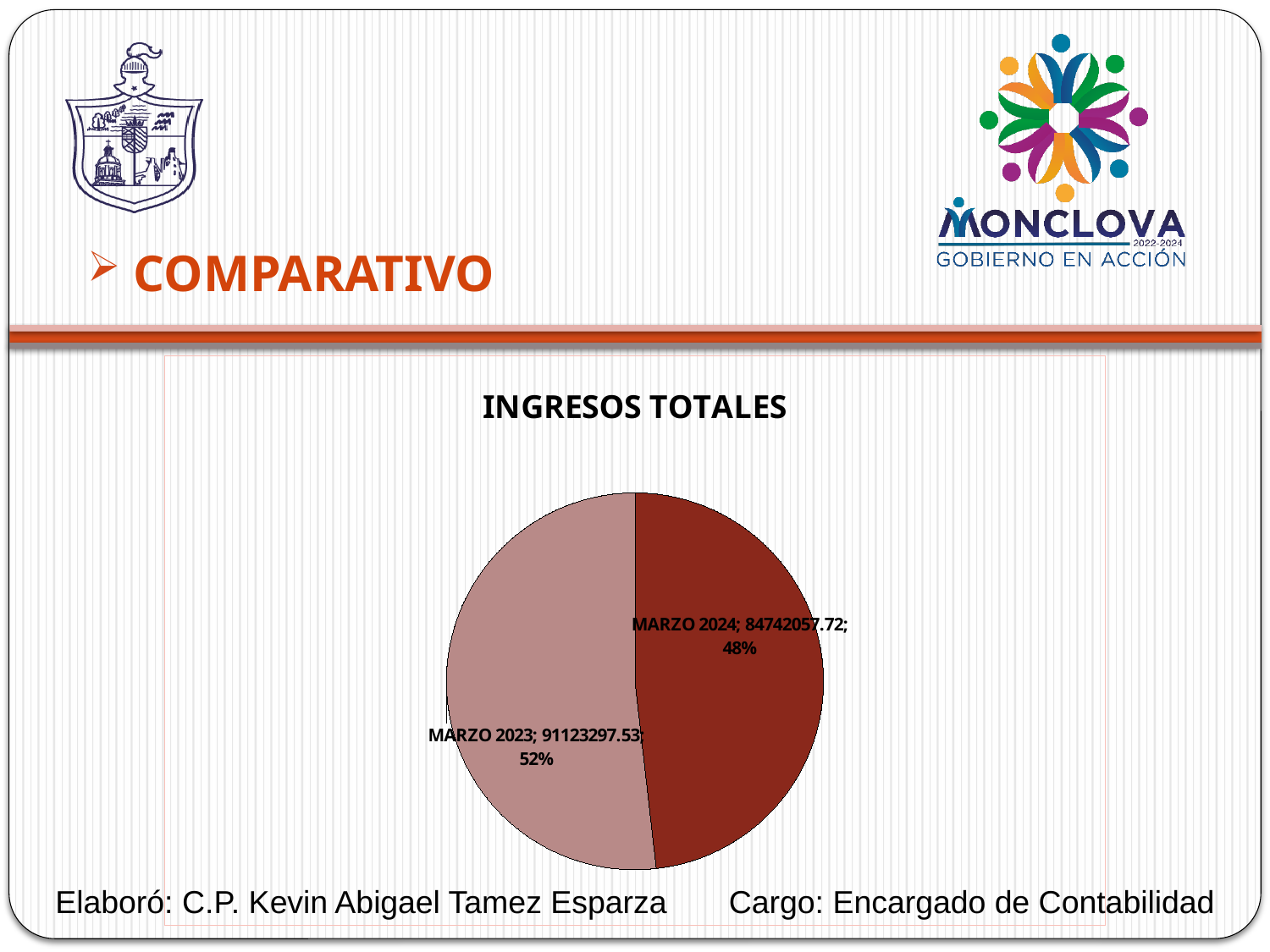
What is the value for MARZO 2023? 91123297.53 Which slice is the smallest? MARZO 2024 What kind of chart is shown on the slide? pie chart What share of the pie does MARZO 2024 represent? 48% What is the total of the two values shown in the pie chart? 175865355.25 How many slices does the pie chart have? 2 Which is larger, the value for MARZO 2023 or MARZO 2024? MARZO 2023 What is the value for MARZO 2024? 84742057.72 What share of the pie does MARZO 2023 represent? 52% What is the title of the chart? INGRESOS TOTALES What is the difference between the values for MARZO 2023 and MARZO 2024? 6381239.81 Which slice is the largest? MARZO 2023